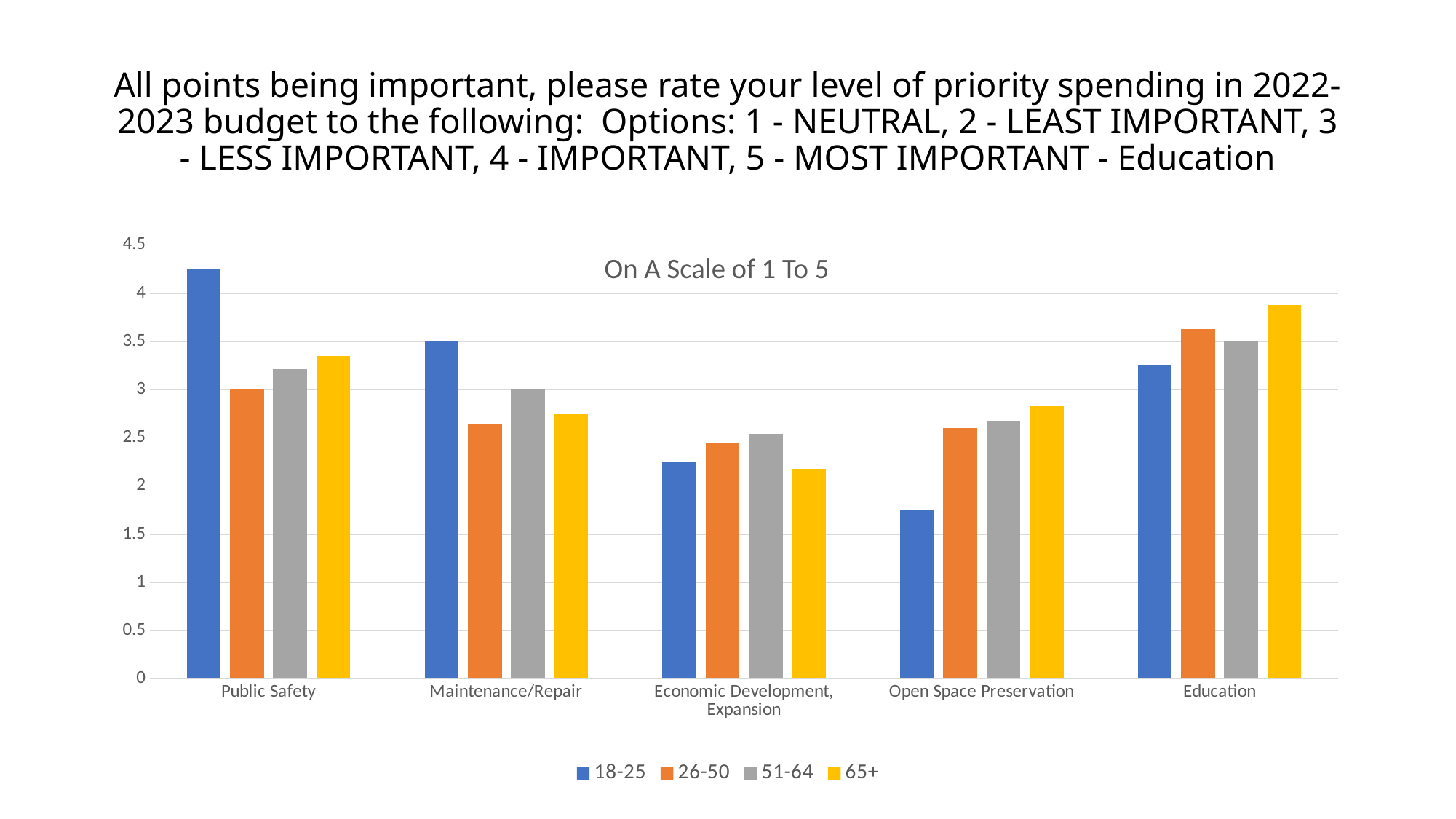
Is the value for 18-25 in Public Safety greater or less than 4? greater In Public Safety, which is larger: the value for 18-25 or the value for 26-50? 18-25 What text appears as the chart's title inside the plot area? On A Scale of 1 To 5 Is the value for 65+ in Education greater or less than 3.5? greater How many series does the legend list? 4 Is the value for 18-25 in Open Space Preservation greater or less than 2? less How many categories are shown on the x axis? 5 What kind of chart is shown on the slide? bar chart Which category has the lowest value for the 18-25 series? Open Space Preservation Which category has the highest value for the 18-25 series? Public Safety In Education, which is larger: the value for 65+ or the value for 18-25? 65+